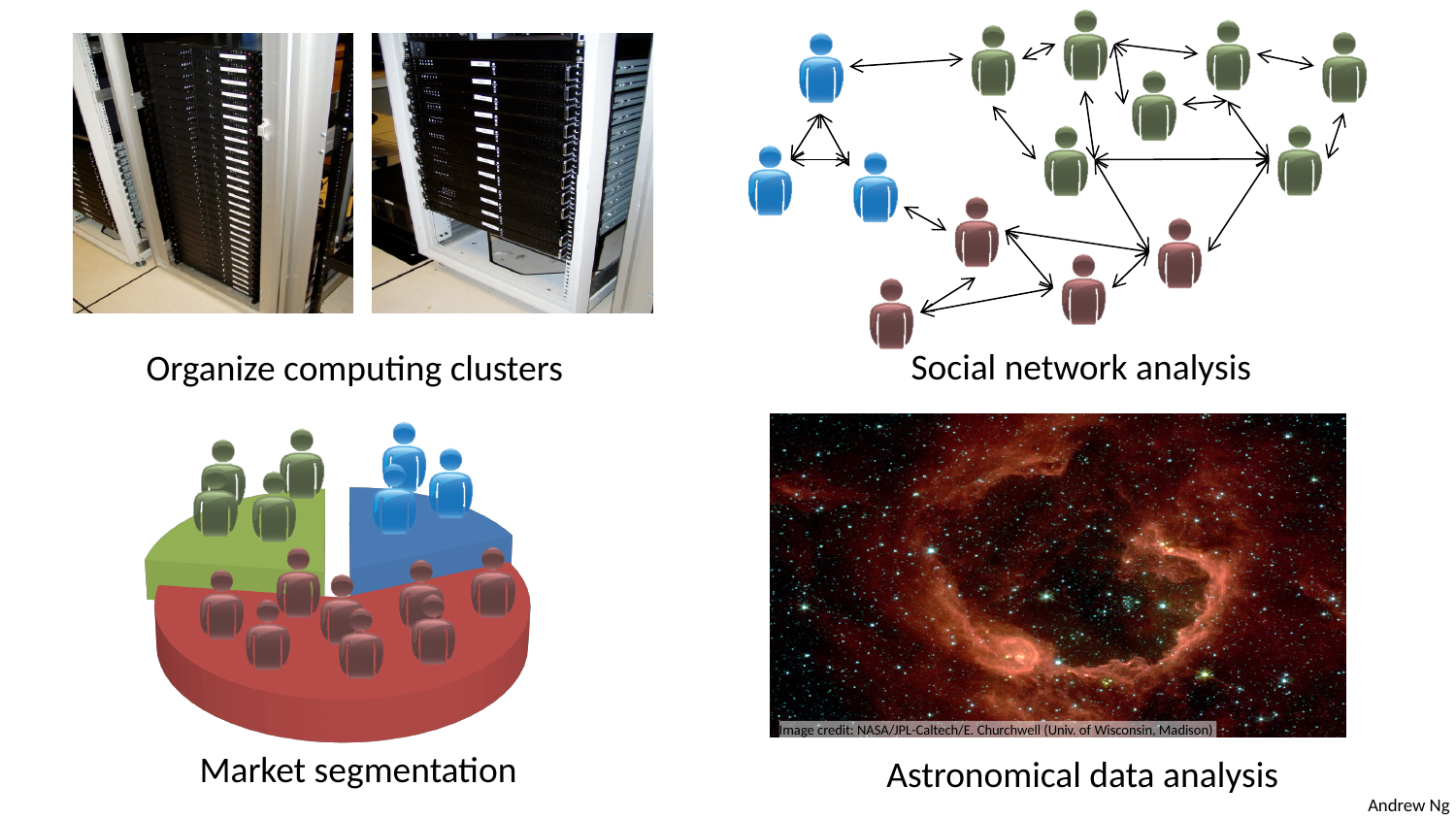
In the "Market segmentation" pie chart, which colour slice is the largest? red What colours are the three slices of the "Market segmentation" pie chart? green, blue and red In the "Market segmentation" pie chart, is the red slice or the green slice larger? red Does the "Market segmentation" pie chart show any data labels or percentages on its slices? No How many slices does the "Market segmentation" pie chart have? 3 In the "Market segmentation" pie chart, is the red slice or the blue slice larger? red What kind of chart is shown under the "Market segmentation" label? pie chart